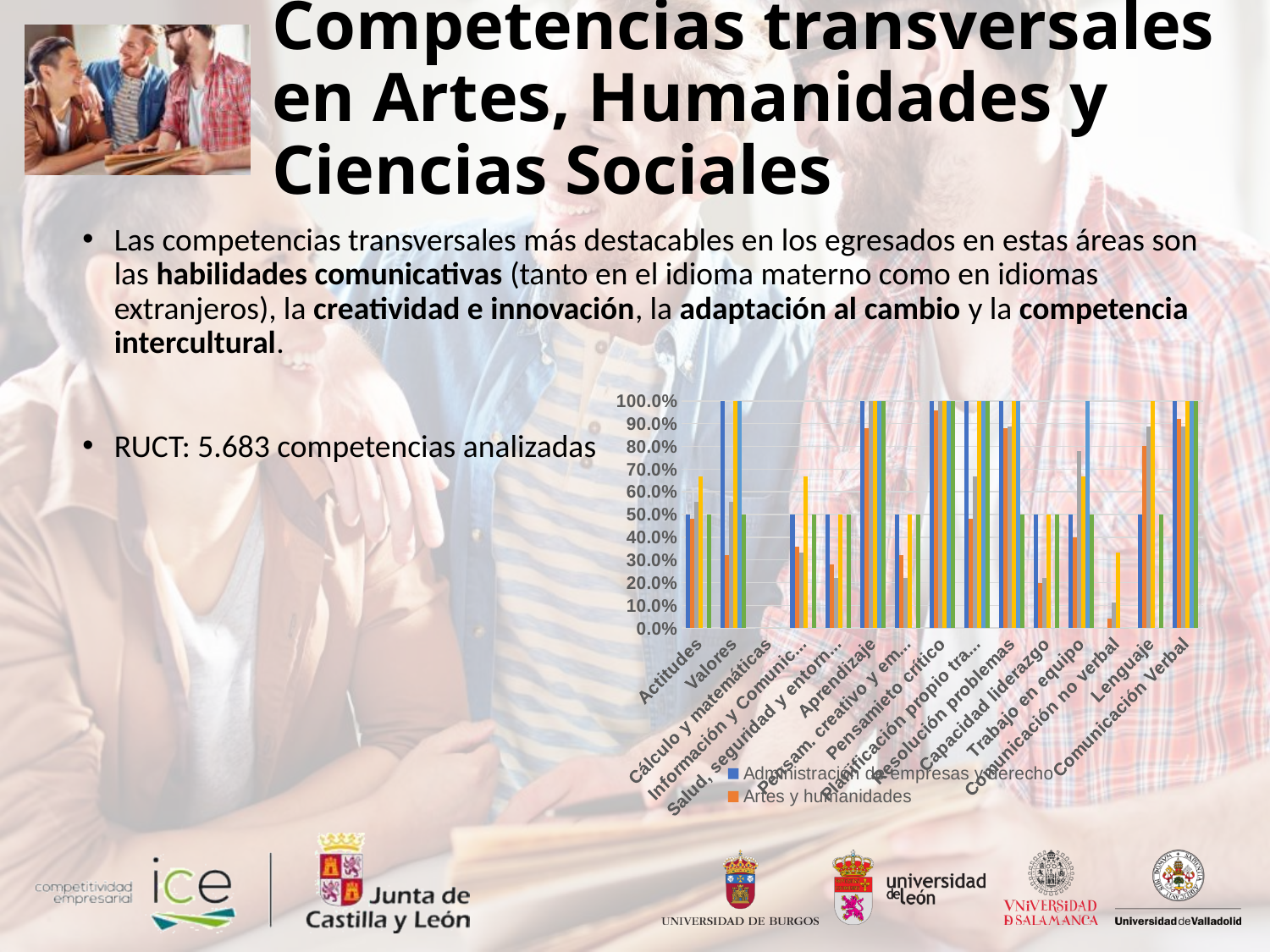
Is the value for Administración de empresas y derecho in the Comunicación Verbal category greater or less than 80%? greater Which series is shown in orange in the chart legend? Artes y humanidades What kind of chart is shown on the slide? bar chart Is the value for Artes y humanidades in the Comunicación no verbal category greater or less than 10%? less Is the value for Administración de empresas y derecho in the Valores category greater or less than 90%? greater What is the highest value shown on the chart's y axis? 100.0% In the Valores category, which is larger: Administración de empresas y derecho or Artes y humanidades? Administración de empresas y derecho How many competency categories are shown along the x axis of the chart? 15 In the Lenguaje category, which is larger: Administración de empresas y derecho or Artes y humanidades? Artes y humanidades